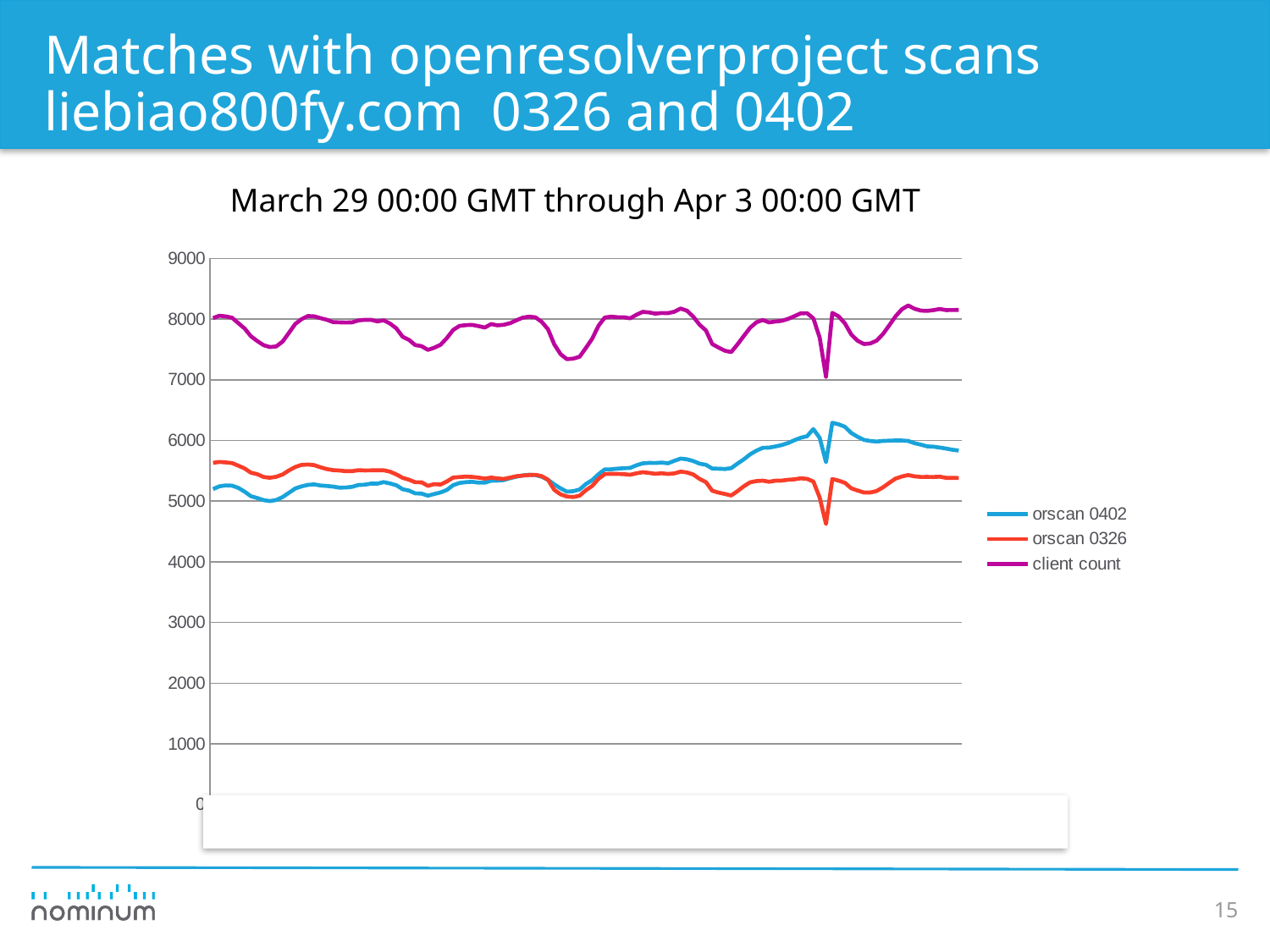
Which series is plotted in magenta? client count What time range does the chart subtitle say the data covers? March 29 00:00 GMT through Apr 3 00:00 GMT How many series does the legend list? 3 Is the client count series greater or less than 7000 for almost the entire period? greater At the right end of the chart, which series is larger: orscan 0402 or orscan 0326? orscan 0402 What kind of chart is shown on the slide? line chart What is the highest value shown on the vertical axis? 9000 At the left end of the chart, which series is larger: orscan 0402 or orscan 0326? orscan 0326 Does the orscan 0402 series generally rise or fall from the left of the chart to the right? rise Is the orscan 0326 series greater or less than 6000 throughout the chart? less Is the orscan 0402 series greater or less than 4000 throughout the chart? greater Which series has the highest values throughout the chart? client count